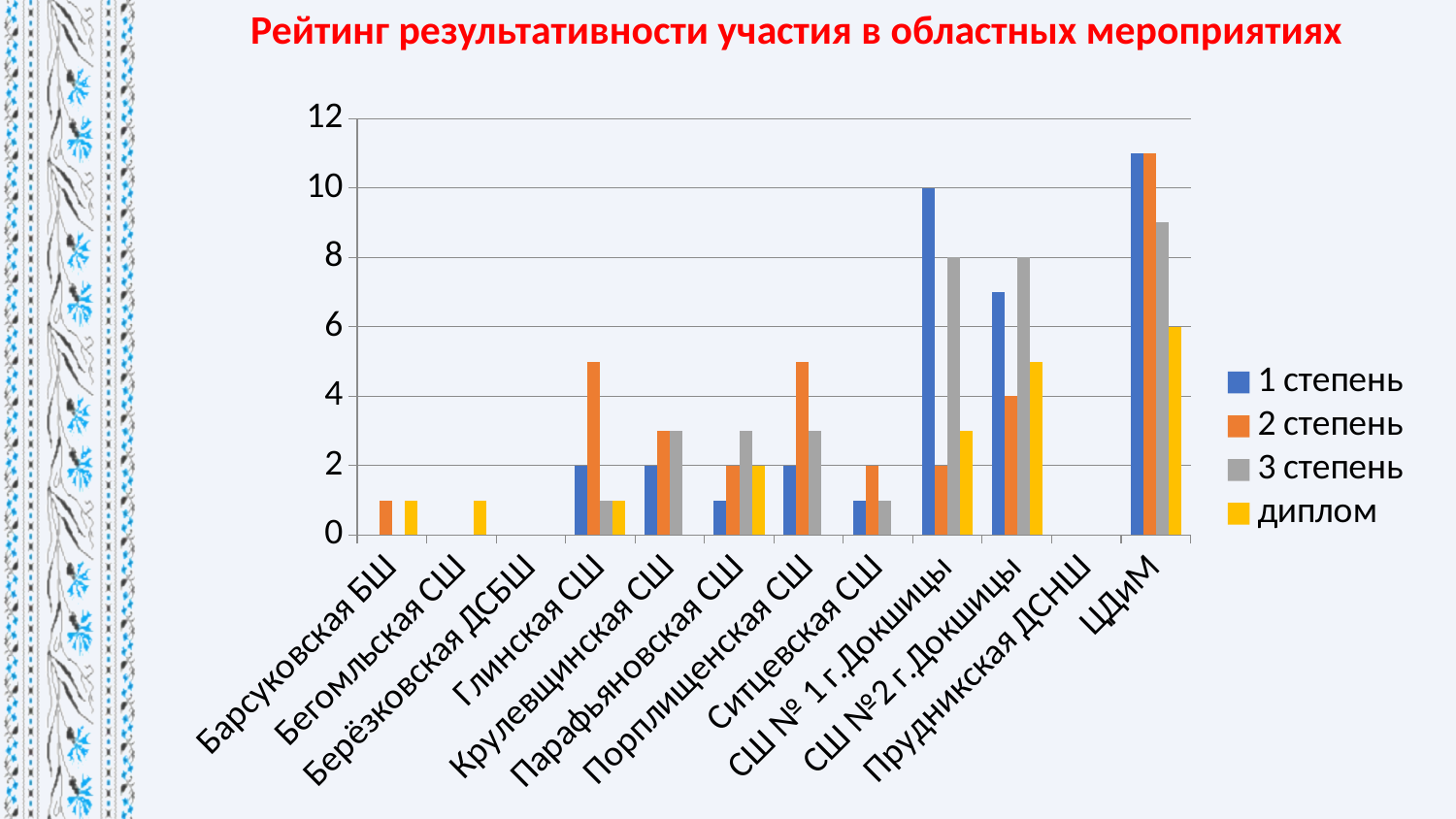
What is the value of "1 степень" for СШ № 1 г.Докшицы? 10 What kind of chart is shown on the slide? bar chart Is the value of "1 степень" for ЦДиМ greater or less than 10? greater What is the value of "диплом" for ЦДиМ? 6 How many series does the legend list? 4 What is the difference between "1 степень" and "3 степень" for СШ № 1 г.Докшицы? 2 What is the value of "2 степень" for СШ №2 г.Докшицы? 4 Which category has the highest value for "1 степень"? ЦДиМ How many categories (institutions) are shown on the x axis? 12 What is the value of "3 степень" for СШ №2 г.Докшицы? 8 Which is larger: "1 степень" for СШ № 1 г.Докшицы or "1 степень" for СШ №2 г.Докшицы? СШ № 1 г.Докшицы Is the value of "2 степень" for Глинская СШ greater or less than 4? greater